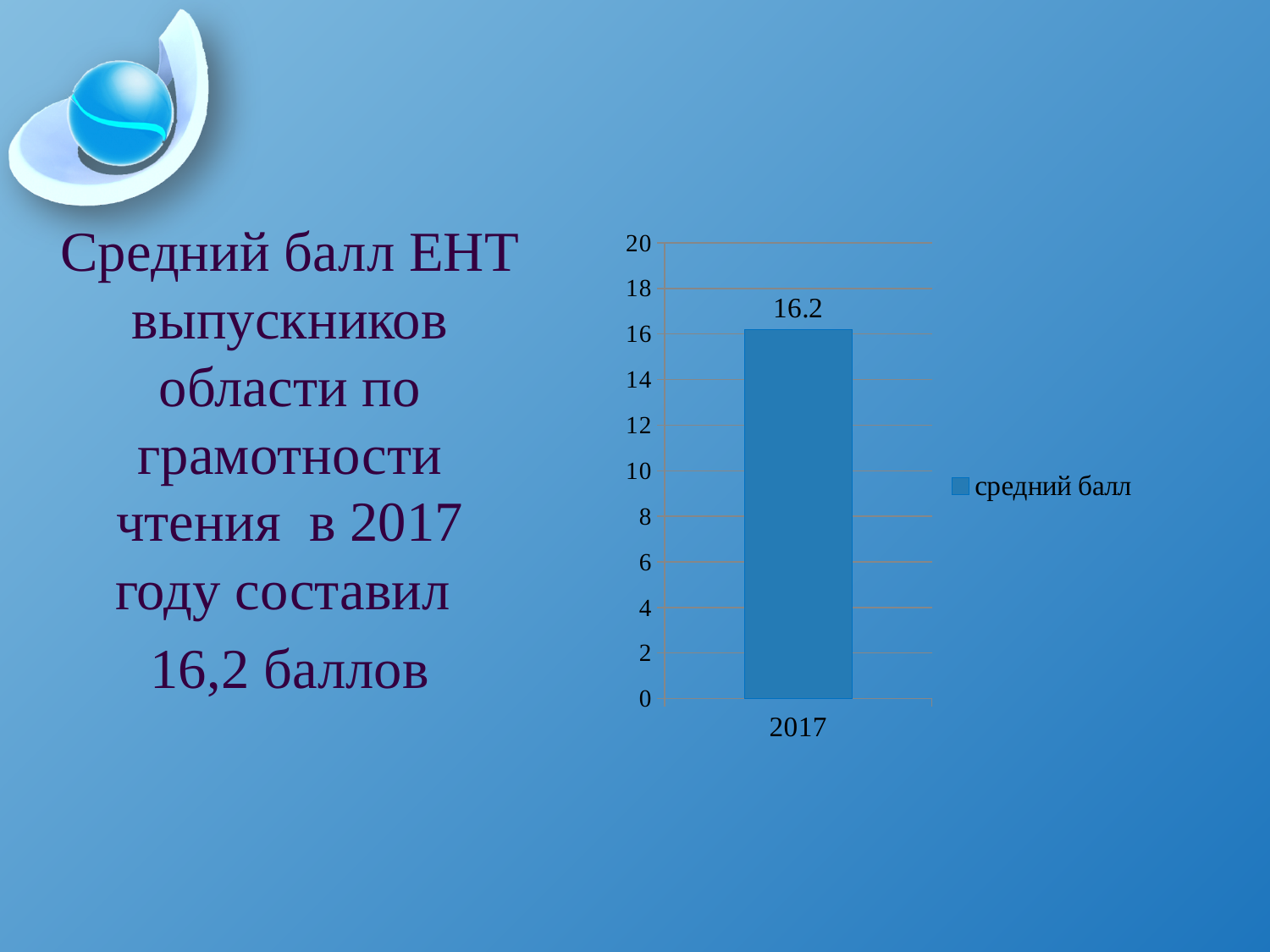
What is the maximum value shown on the vertical axis? 20 Is the value for 2017 greater or less than 18? less How many bars are plotted in the chart? 1 Which category label appears on the horizontal axis? 2017 What kind of chart is shown on the slide? bar chart What is the value of the bar for 2017? 16.2 What is the name of the series shown in the legend? средний балл How many series does the legend list? 1 Is the value for 2017 greater or less than 10? greater